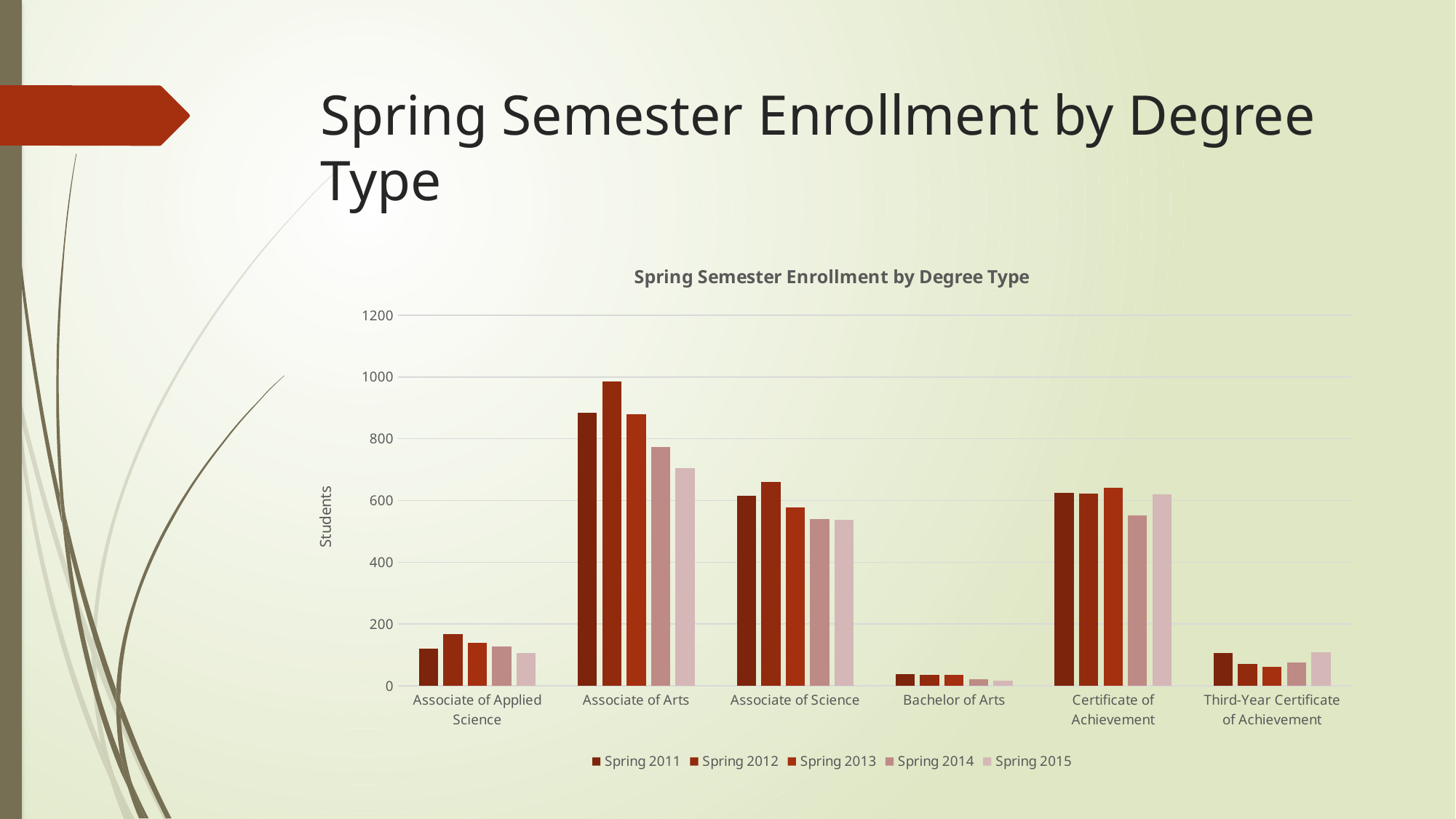
Do the Associate of Arts values rise or fall from Spring 2012 to Spring 2015? fall Which degree type has the highest Spring 2012 enrollment? Associate of Arts Is the Spring 2012 value for Associate of Arts greater or less than 800? greater How many series does the legend list? 5 Is the Spring 2015 value for Associate of Arts greater or less than 800? less Is the Spring 2014 value for Certificate of Achievement greater or less than 600? less What kind of chart is shown on the slide? bar chart For Associate of Science, which is larger: the Spring 2011 value or the Spring 2013 value? Spring 2011 For Associate of Arts, which is larger: the Spring 2012 value or the Spring 2015 value? Spring 2012 How many degree types are shown on the x axis? 6 What is the label on the vertical axis? Students Which degree type has the lowest enrollment across all semesters? Bachelor of Arts